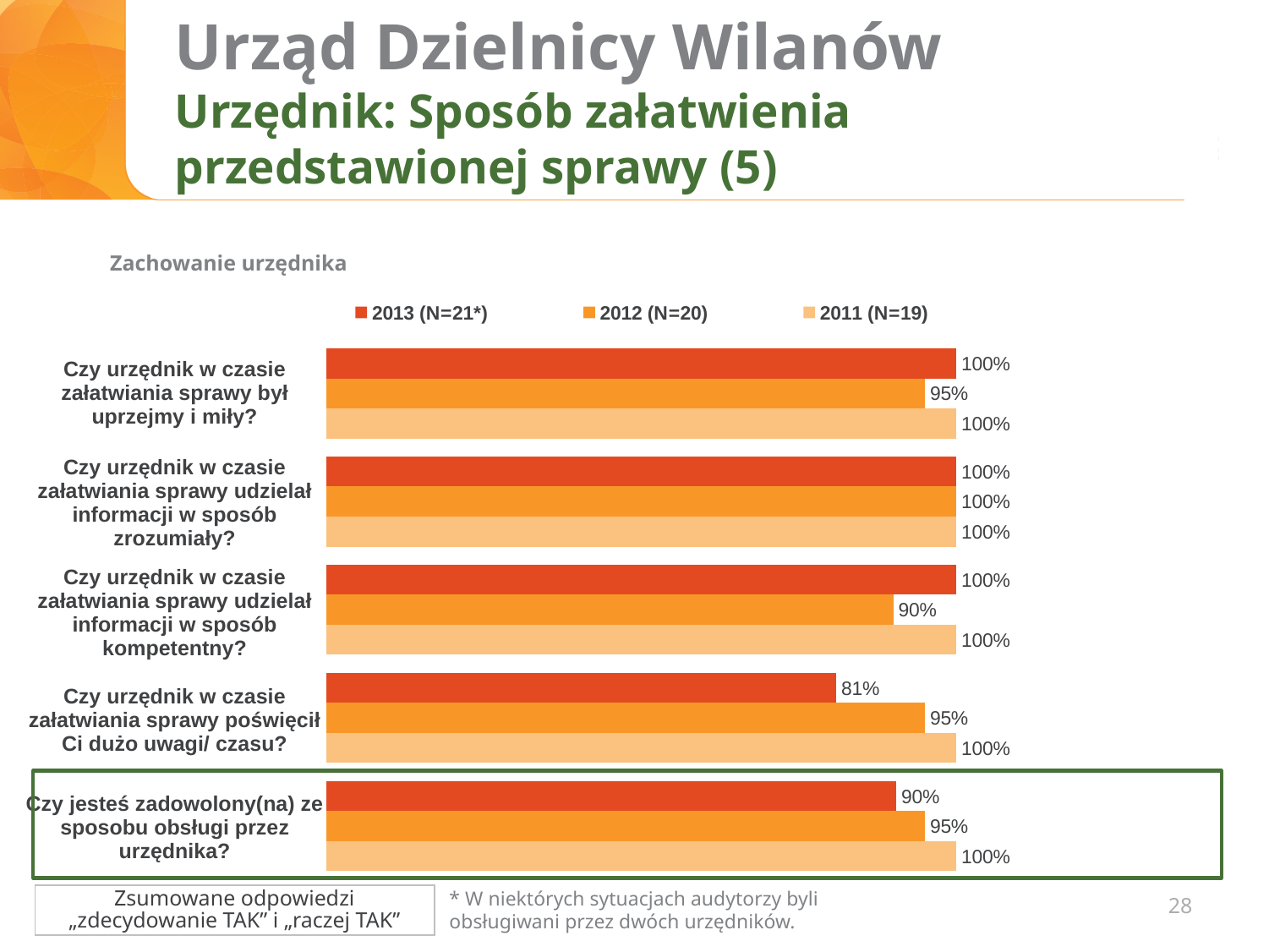
What is the 2012 (N=20) value for "Czy urzędnik w czasie załatwiania sprawy był uprzejmy i miły?"? 95% What is the title shown above the chart? Zachowanie urzędnika How many question categories are plotted in the chart? 5 What type of chart is shown on the slide? bar chart What is the 2012 (N=20) value for "Czy urzędnik w czasie załatwiania sprawy udzielał informacji w sposób kompetentny?"? 90% What is the 2013 (N=21*) value for "Czy urzędnik w czasie załatwiania sprawy poświęcił Ci dużo uwagi/ czasu?"? 81% What is the 2011 (N=19) value for "Czy jesteś zadowolony(na) ze sposobu obsługi przez urzędnika?"? 100% For "Czy jesteś zadowolony(na) ze sposobu obsługi przez urzędnika?", which is larger: the 2013 (N=21*) value or the 2012 (N=20) value? 2012 (N=20) Which category has the lowest 2013 (N=21*) value? Czy urzędnik w czasie załatwiania sprawy poświęcił Ci dużo uwagi/ czasu? What is the difference between the 2012 (N=20) and 2013 (N=21*) values for "Czy jesteś zadowolony(na) ze sposobu obsługi przez urzędnika?"? 5% What is the difference between the 2011 (N=19) and 2013 (N=21*) values for "Czy urzędnik w czasie załatwiania sprawy poświęcił Ci dużo uwagi/ czasu?"? 19% How many series does the legend list? 3